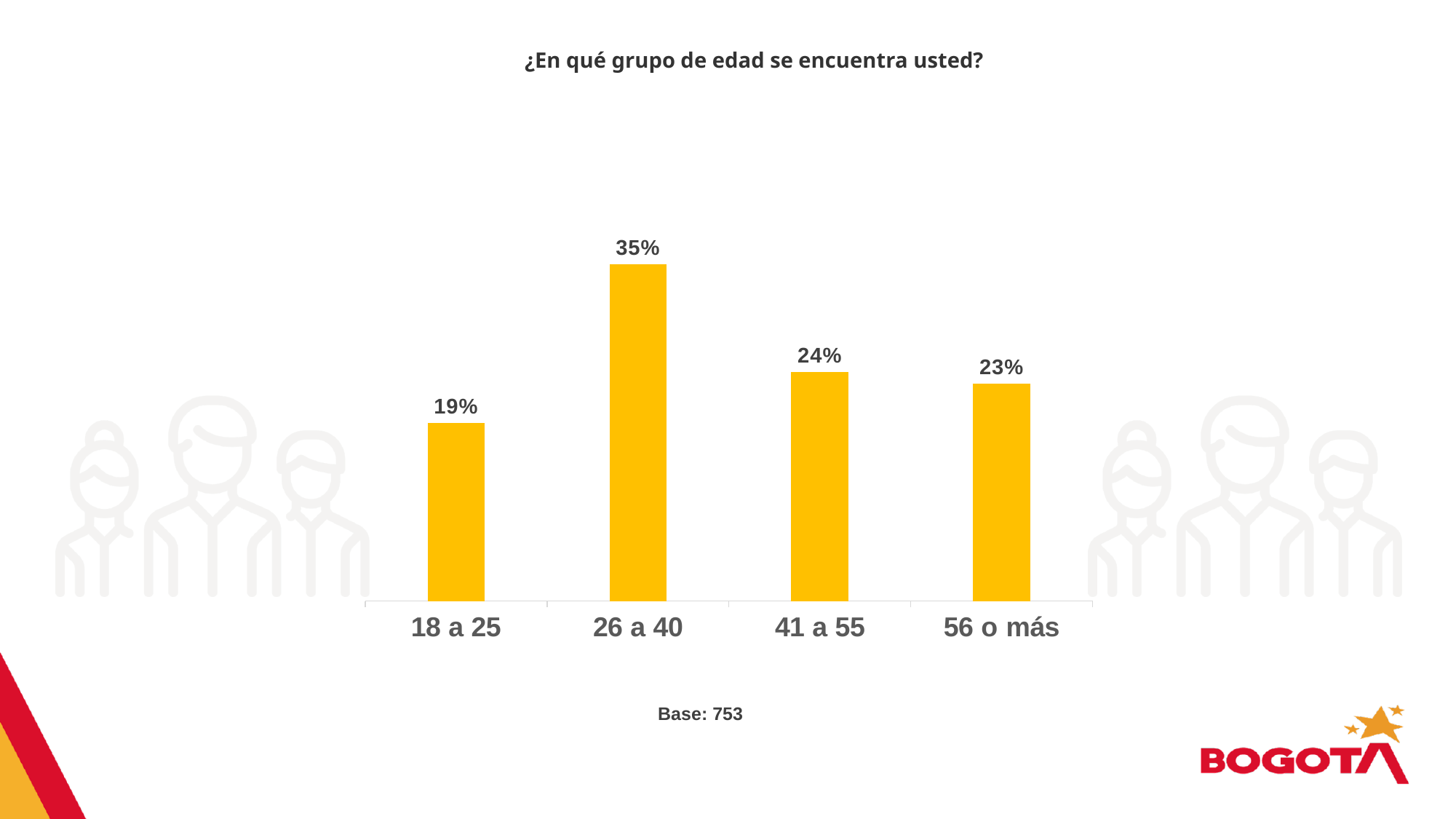
Which age group has the highest percentage of respondents? 26 a 40 Which is larger, the value for 41 a 55 or the value for 56 o más? 41 a 55 How many age groups are shown in the chart? 4 What is the title of the chart? ¿En qué grupo de edad se encuentra usted? Which age group has the lowest percentage of respondents? 18 a 25 What kind of chart is shown on the slide? Bar chart What percentage of respondents are in the 18 a 25 age group? 19% What is the difference in percentage points between the 26 a 40 group and the 18 a 25 group? 16 What percentage of respondents are in the 26 a 40 age group? 35% What percentage of respondents are in the 56 o más age group? 23% What percentage of respondents are in the 41 a 55 age group? 24% What is the base (number of respondents) stated below the chart? 753